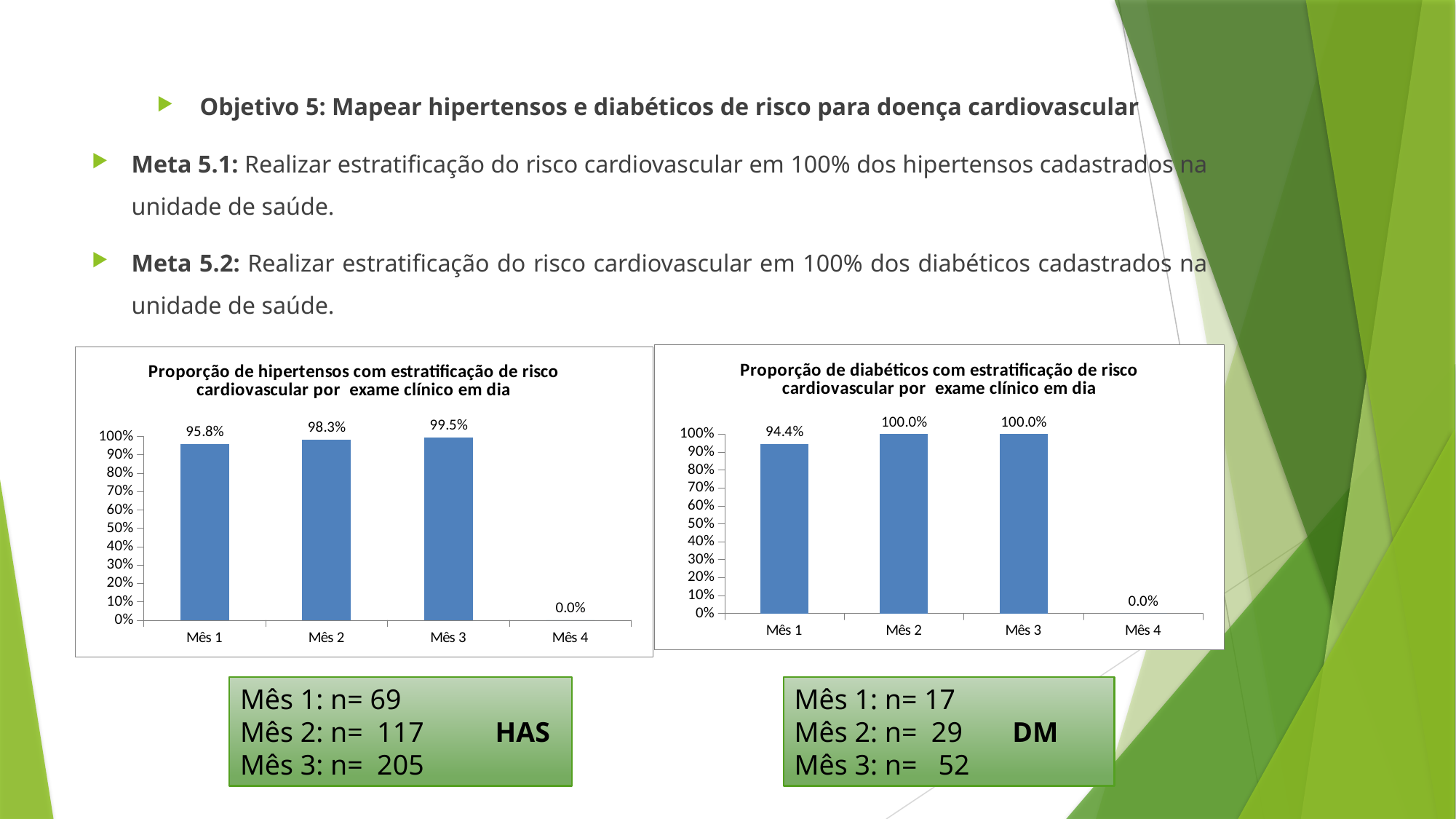
In the left chart (hipertensos), which month has the highest value? Mês 3 In the left chart (hipertensos), which is larger, the value for Mês 2 or the value for Mês 1? Mês 2 In the right chart (diabéticos), which month has the lowest value? Mês 4 In the right chart (diabéticos), what is the value for Mês 2? 100.0% In the left chart (hipertensos), what is the value for Mês 3? 99.5% What kind of chart is the right chart (diabéticos)? Bar chart In the left chart (hipertensos), what is the difference between the values for Mês 3 and Mês 1? 3.7% In the left chart (hipertensos), do the values rise or fall from Mês 1 to Mês 3? Rise In the left chart (Proporção de hipertensos com estratificação de risco cardiovascular por exame clínico em dia), what is the value for Mês 1? 95.8% In the right chart (diabéticos), what is the difference between the values for Mês 2 and Mês 1? 5.6% How many categories are shown on the x axis of the left chart (hipertensos)? 4 In the right chart (Proporção de diabéticos com estratificação de risco cardiovascular por exame clínico em dia), what is the value for Mês 1? 94.4%